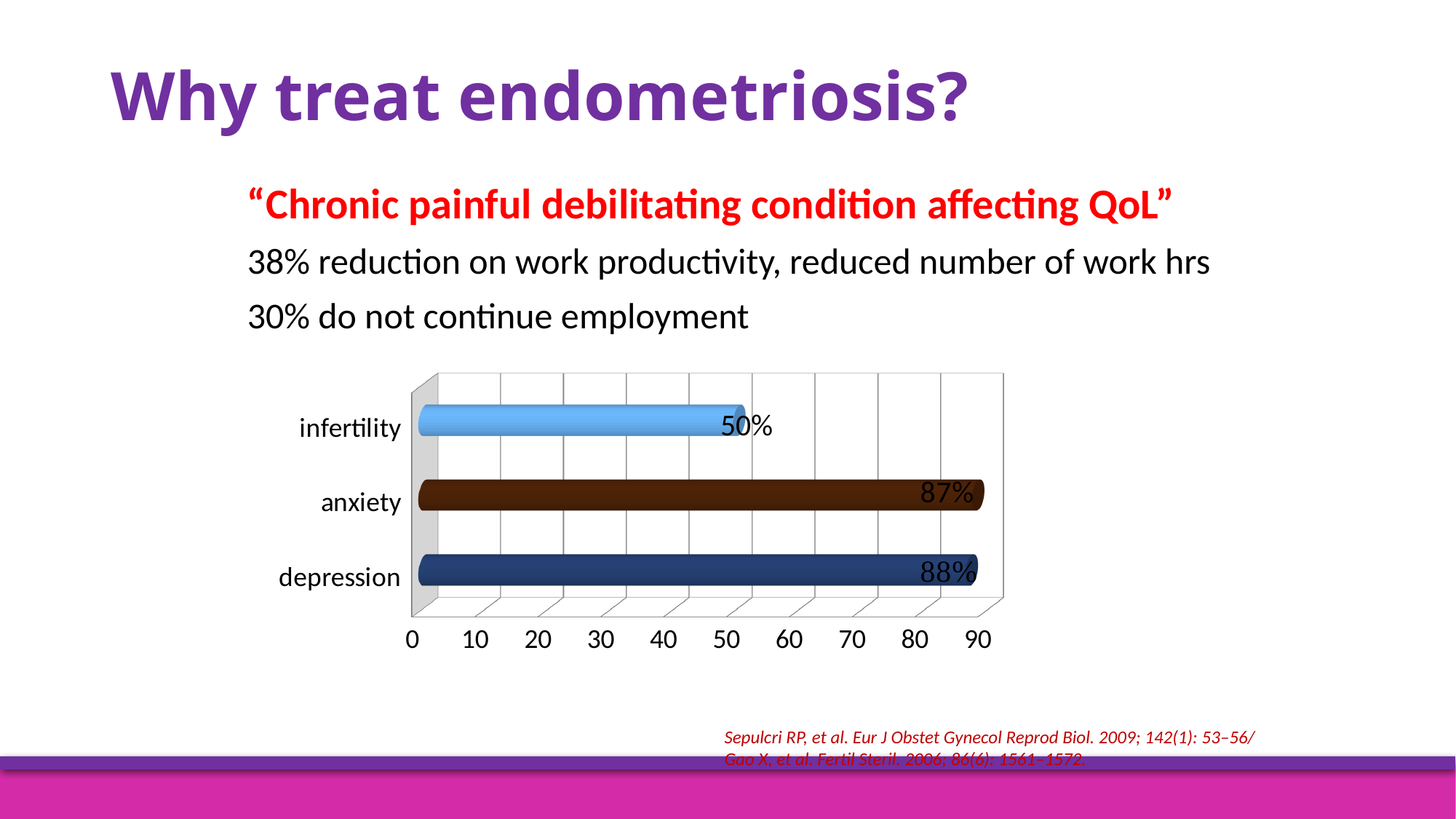
What is the value shown for infertility? 50% How many categories are shown in the chart? 3 What is the value shown for depression? 88% Is the value for infertility greater or less than 40? greater Which category has the lowest value? infertility What kind of chart is shown on the slide? bar chart What is the difference between the values for anxiety and infertility? 37 percentage points What is the value shown for anxiety? 87% Is the value for anxiety greater or less than 80? greater Which is larger, the value for anxiety or the value for infertility? anxiety Which category has the highest value? depression What is the difference between the values for depression and infertility? 38 percentage points